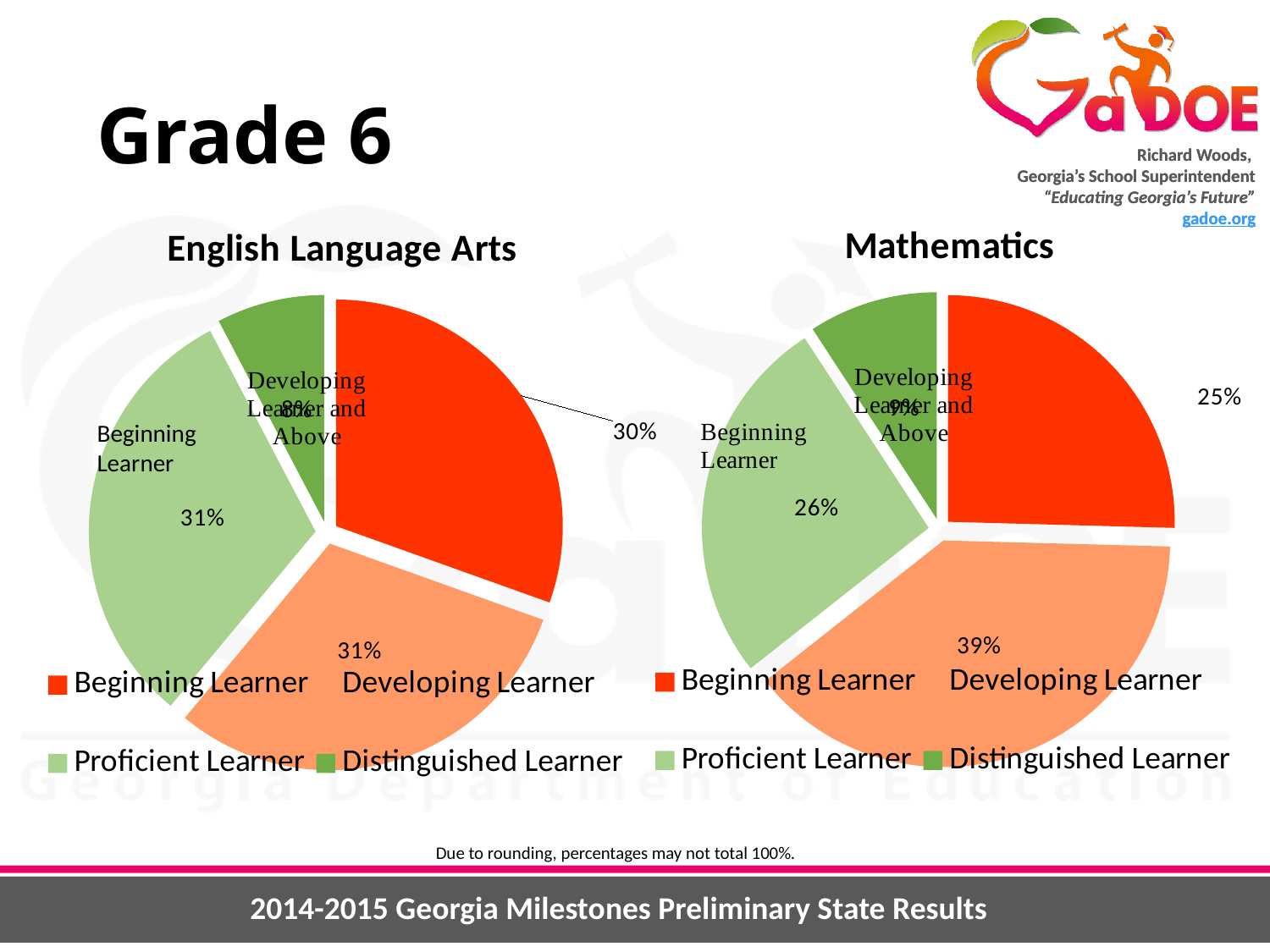
What type of chart is used for English Language Arts? Pie chart In the English Language Arts chart, which category has the smallest slice? Distinguished Learner In the English Language Arts chart, which is larger: Beginning Learner or Proficient Learner? Proficient Learner In the Mathematics chart, which category has the largest slice? Developing Learner In the Mathematics chart, which category has the smallest slice? Distinguished Learner In the Mathematics chart, what percentage is shown for Proficient Learner? 26% In the Mathematics chart, what percentage is shown for Developing Learner? 39% In the Mathematics chart, what is the difference in percentage points between Developing Learner and Beginning Learner? 14 percentage points In the Mathematics chart, what percentage is shown for Beginning Learner? 25% In the English Language Arts chart, what percentage is shown for Beginning Learner? 30% In the English Language Arts chart, what percentage is shown for Developing Learner? 31% How many entries does the legend of the Mathematics chart list? 4